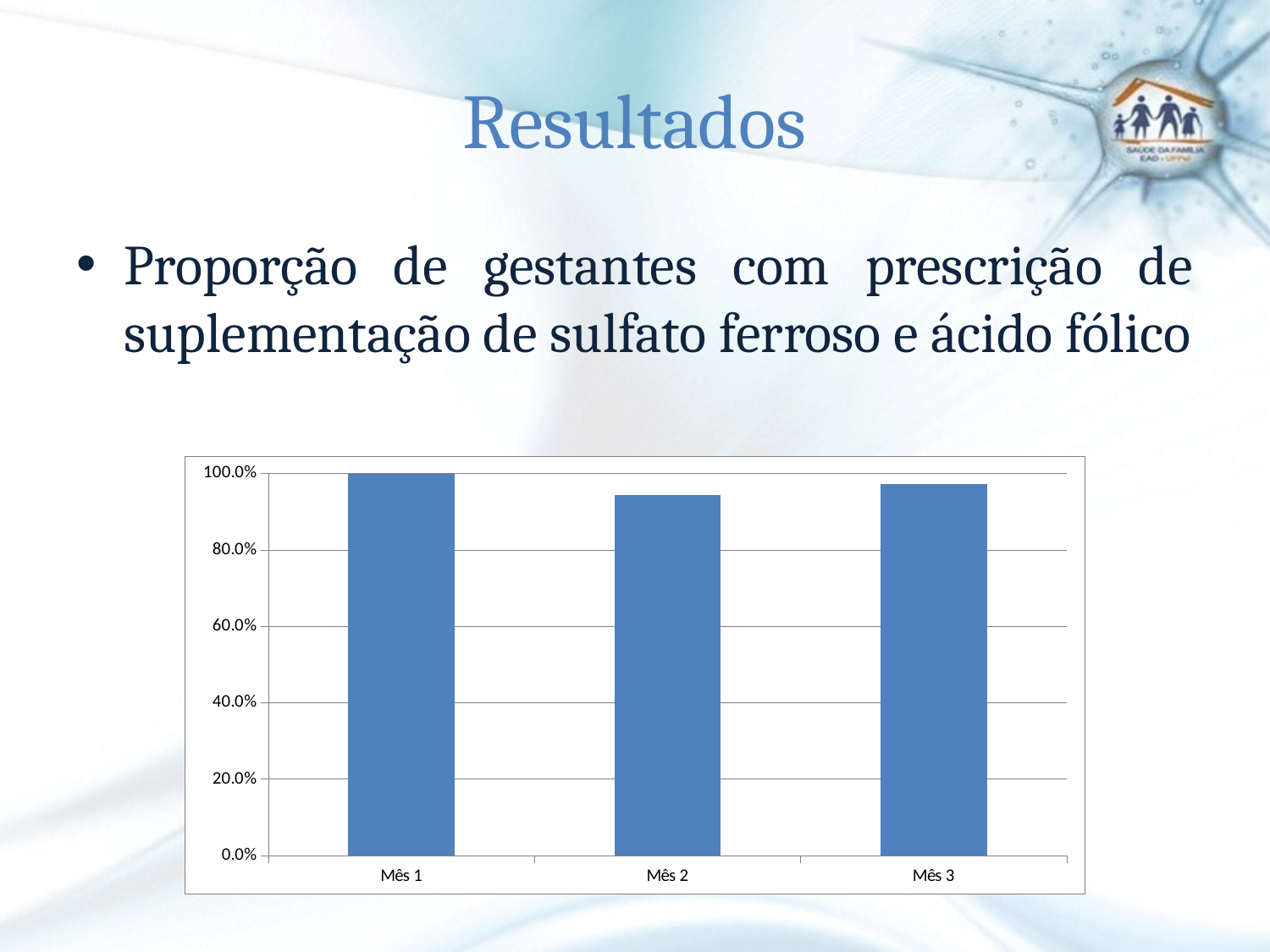
What is the label of the first category on the horizontal axis? Mês 1 Which month has the highest value? Mês 1 Which is larger, the value for Mês 2 or the value for Mês 3? Mês 3 What is the highest tick value shown on the vertical axis? 100.0% Does the value rise or fall from Mês 2 to Mês 3? rise What is the value for Mês 1? 100.0% How many categories (months) are plotted on the chart? 3 Which month has the lowest value? Mês 2 What kind of chart is shown on the slide? Bar chart Is the value for Mês 2 greater or less than 80.0%? greater Is the value for Mês 3 greater or less than 100.0%? less Does the value rise or fall from Mês 1 to Mês 2? fall